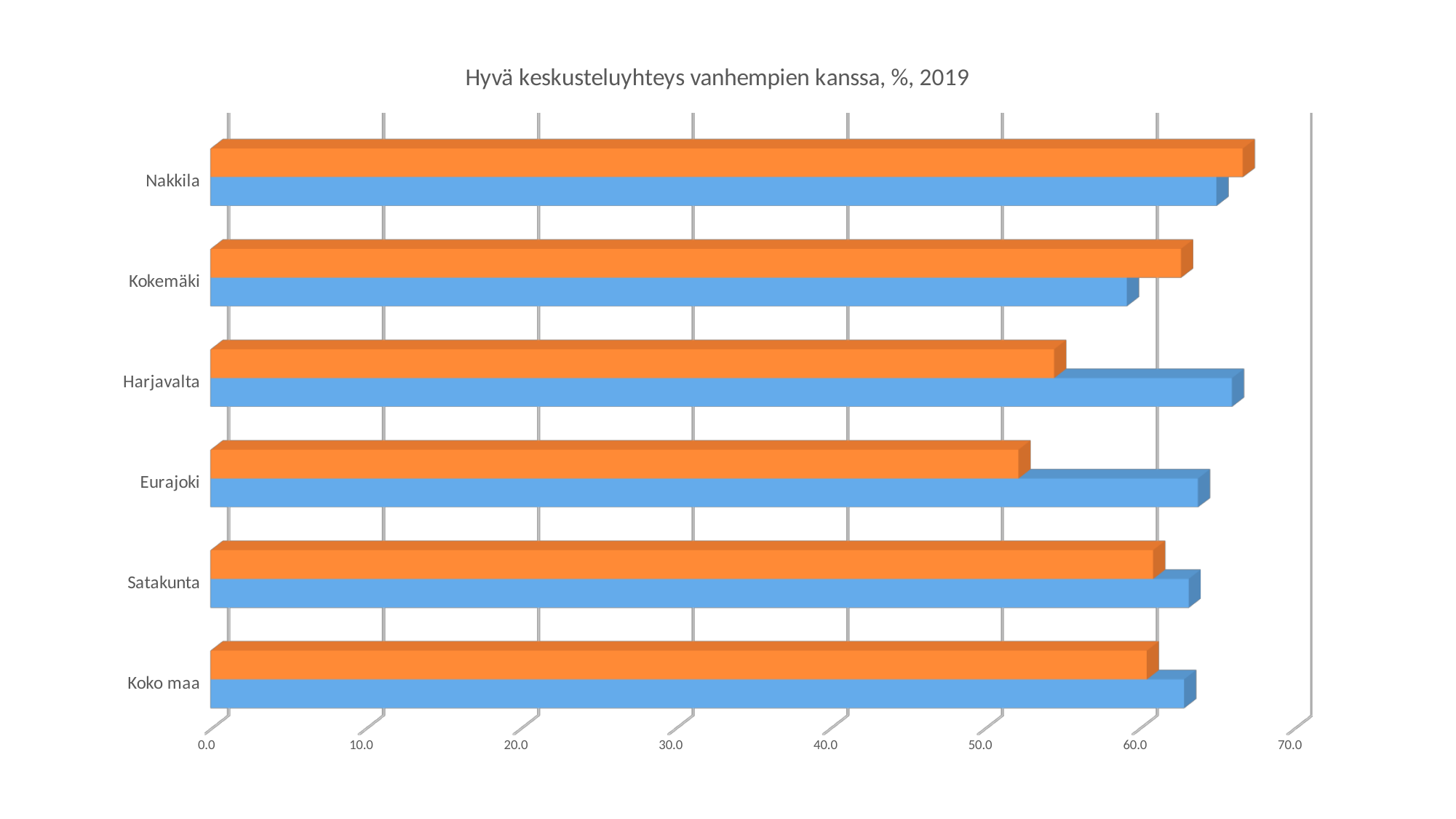
Is the blue bar for Eurajoki greater or less than 60.0? greater Which category has the lowest value for the orange series? Eurajoki What kind of chart is shown on the slide? bar chart Is the orange bar for Harjavalta greater or less than 60.0? less For Nakkila, which bar is longer, the orange one or the blue one? orange How many categories are shown on the vertical axis of the chart? 6 What is the title of the chart? Hyvä keskusteluyhteys vanhempien kanssa, %, 2019 Is the orange bar for Eurajoki greater or less than 50.0? greater For Harjavalta, which bar is longer, the orange one or the blue one? blue Which category has the lowest value for the blue series? Kokemäki What two colours are used for the bars in the chart? orange and blue Which category has the highest value for the orange series? Nakkila